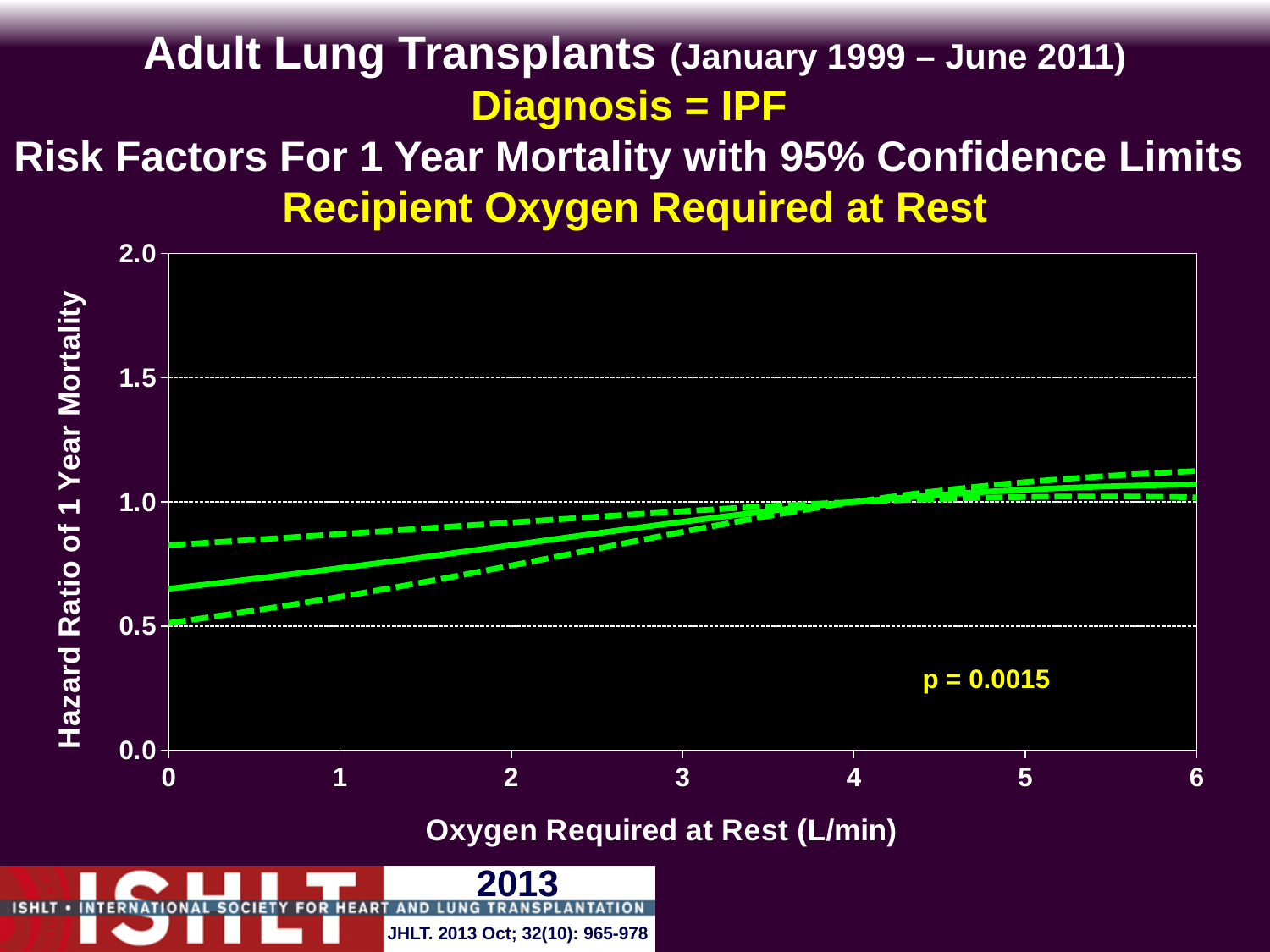
Is the upper confidence limit (upper dashed line) at 0 L/min greater or less than 1.0? less Is the hazard ratio (solid line) at 0 L/min greater or less than 0.5? greater Is the hazard ratio (solid line) at 0 L/min greater or less than 1.0? less Does the solid hazard ratio line rise or fall as oxygen required at rest increases from 0 to 6 L/min? rise What is the maximum value shown on the y axis? 2.0 What p-value is printed on the chart? p = 0.0015 What kind of chart is shown on the slide? line chart How many lines are plotted on the chart? 3